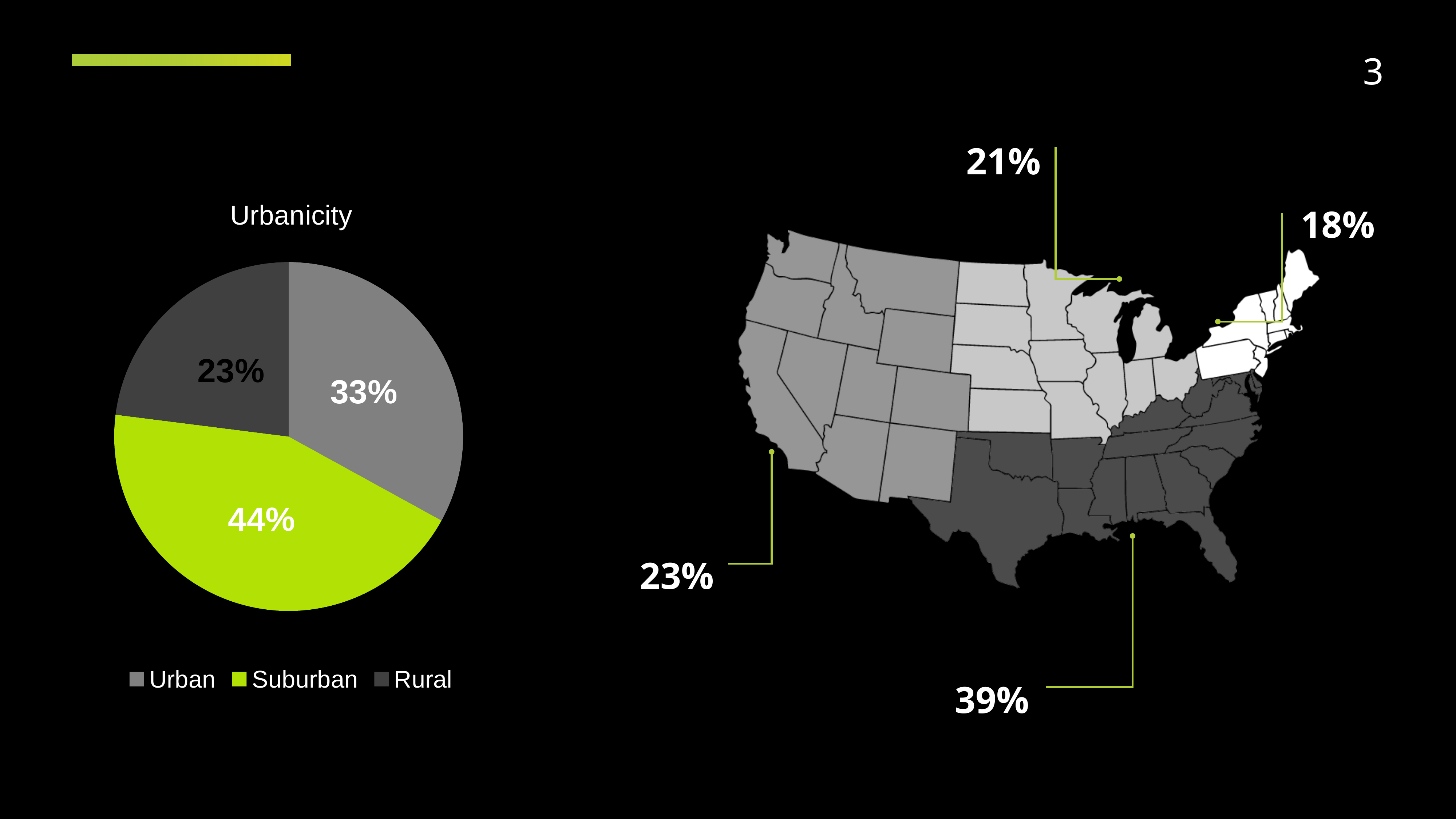
In the Urbanicity pie chart, which category has the smallest share? Rural In the Urbanicity pie chart, what percentage is Urban? 33% In the Urbanicity pie chart, what is the combined share of Urban and Suburban? 77% In the Urbanicity pie chart, what percentage is Suburban? 44% How many categories does the Urbanicity pie chart show? 3 In the Urbanicity pie chart, which category has the largest share? Suburban In the Urbanicity pie chart, what percentage is Rural? 23% In the Urbanicity pie chart, what is the difference between the Urban and Rural shares? 10% In the Urbanicity pie chart, how many percentage points larger is Suburban than Urban? 11% In the Urbanicity pie chart, which category is shown in green? Suburban What kind of chart is the Urbanicity chart? Pie chart In the Urbanicity pie chart, which is larger, Urban or Rural? Urban